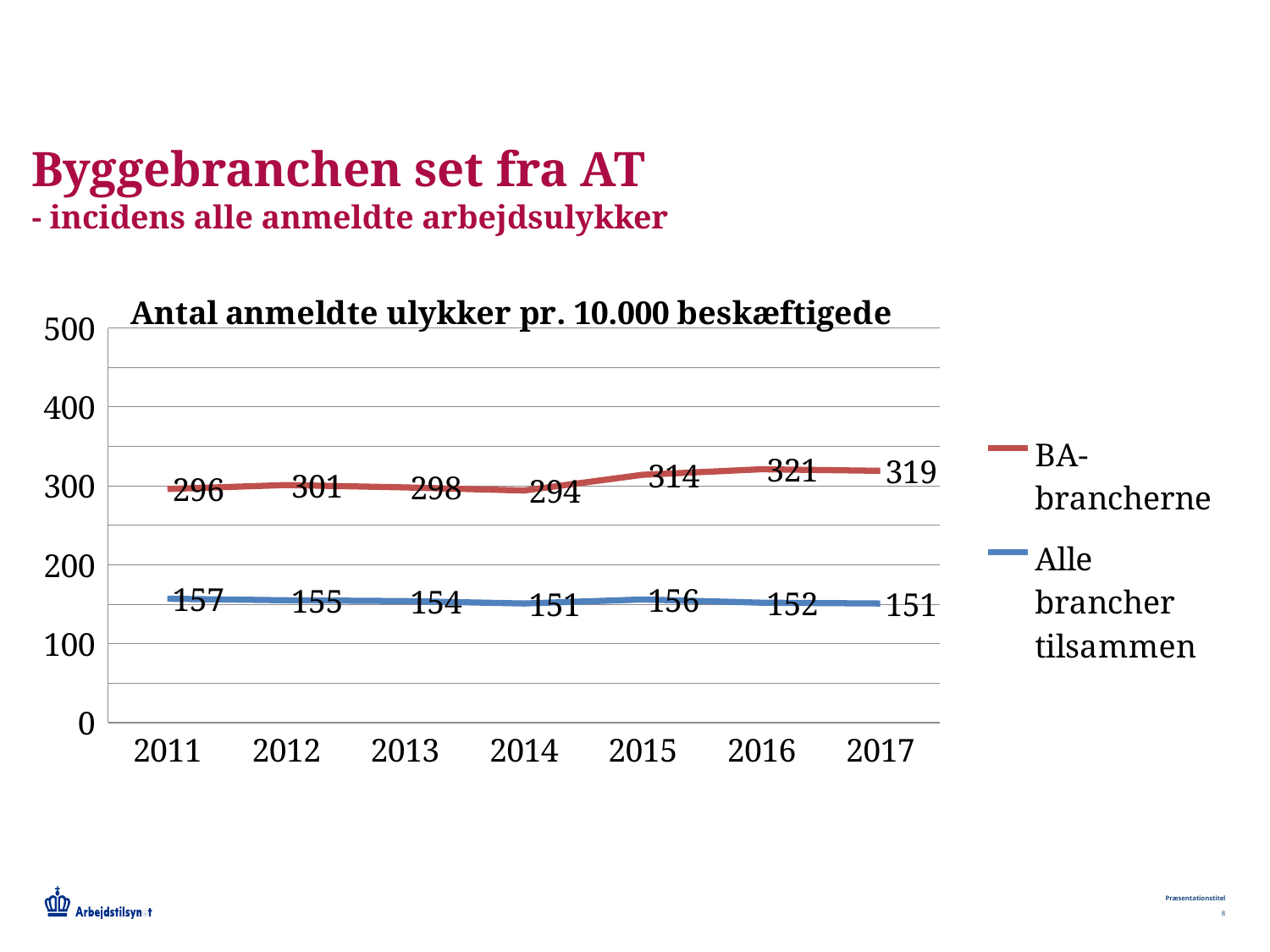
How many series does the legend list? 2 What is the value for BA-brancherne in 2011? 296 How many years are shown on the x axis? 7 What is the difference between BA-brancherne and Alle brancher tilsammen in 2017? 168 In which year is the value for BA-brancherne lowest? 2014 What is the value for Alle brancher tilsammen in 2014? 151 What is the value for BA-brancherne in 2016? 321 Which series has the larger value in 2015, BA-brancherne or Alle brancher tilsammen? BA-brancherne What kind of chart is shown on the slide? line chart In which year is the value for BA-brancherne highest? 2016 What is the title of the chart? Antal anmeldte ulykker pr. 10.000 beskæftigede Is the value for BA-brancherne in 2017 greater or less than 400? less